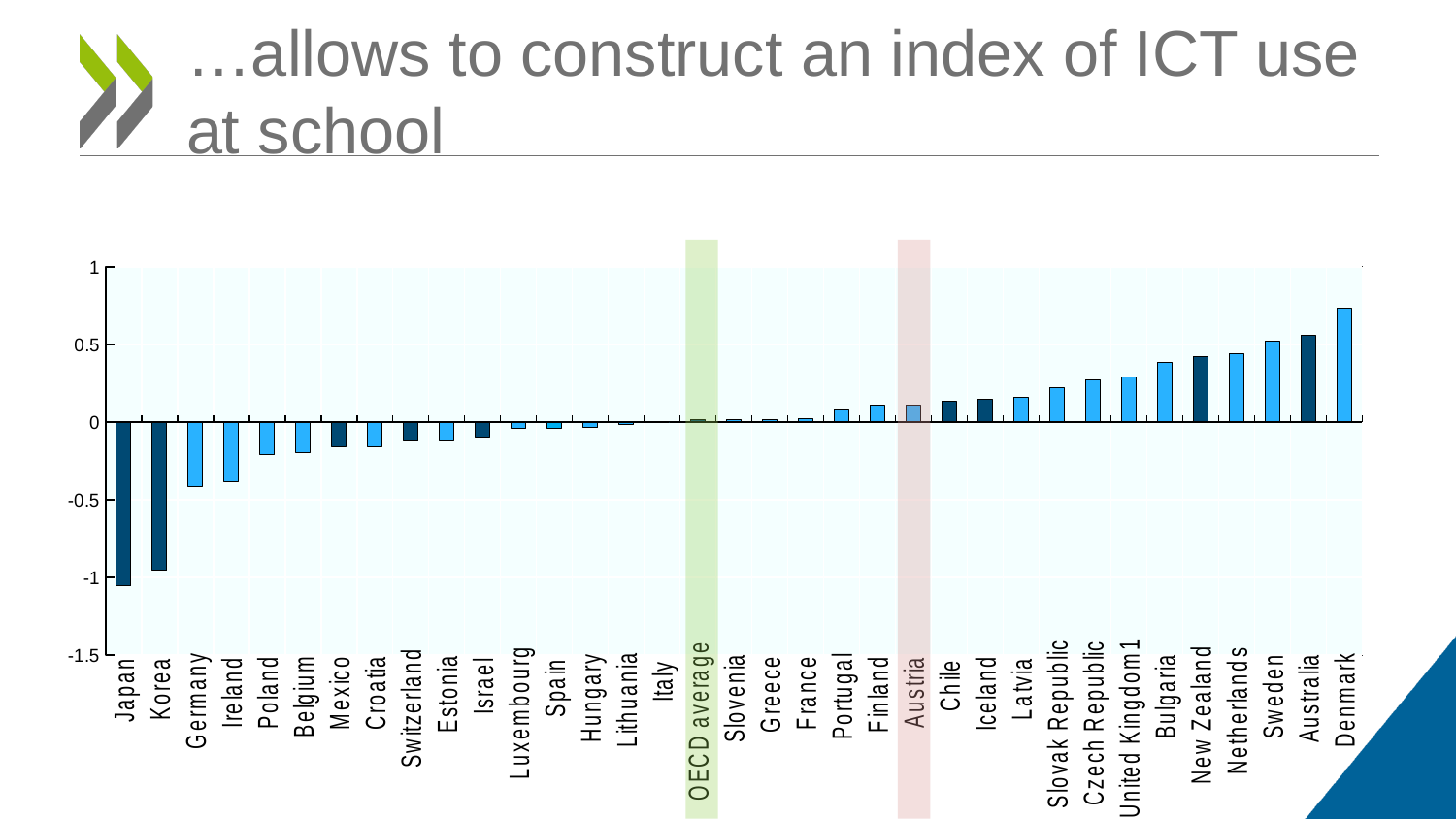
Which has the larger value, Ireland or Poland? Poland Is the value for Denmark greater or less than 0.5? greater Which country has the highest value in the chart? Denmark Which country has the lowest value in the chart? Japan Is the value for Japan greater or less than -0.5? less Is the value for Bulgaria greater or less than 0.5? less Do the values rise or fall moving from left to right along the x axis? rise What kind of chart is shown on the slide? bar chart How many categories (bars) are shown on the x axis? 35 Which two categories are highlighted with shaded vertical bands in the chart? OECD average and Austria Which has the larger value, Germany or Denmark? Denmark